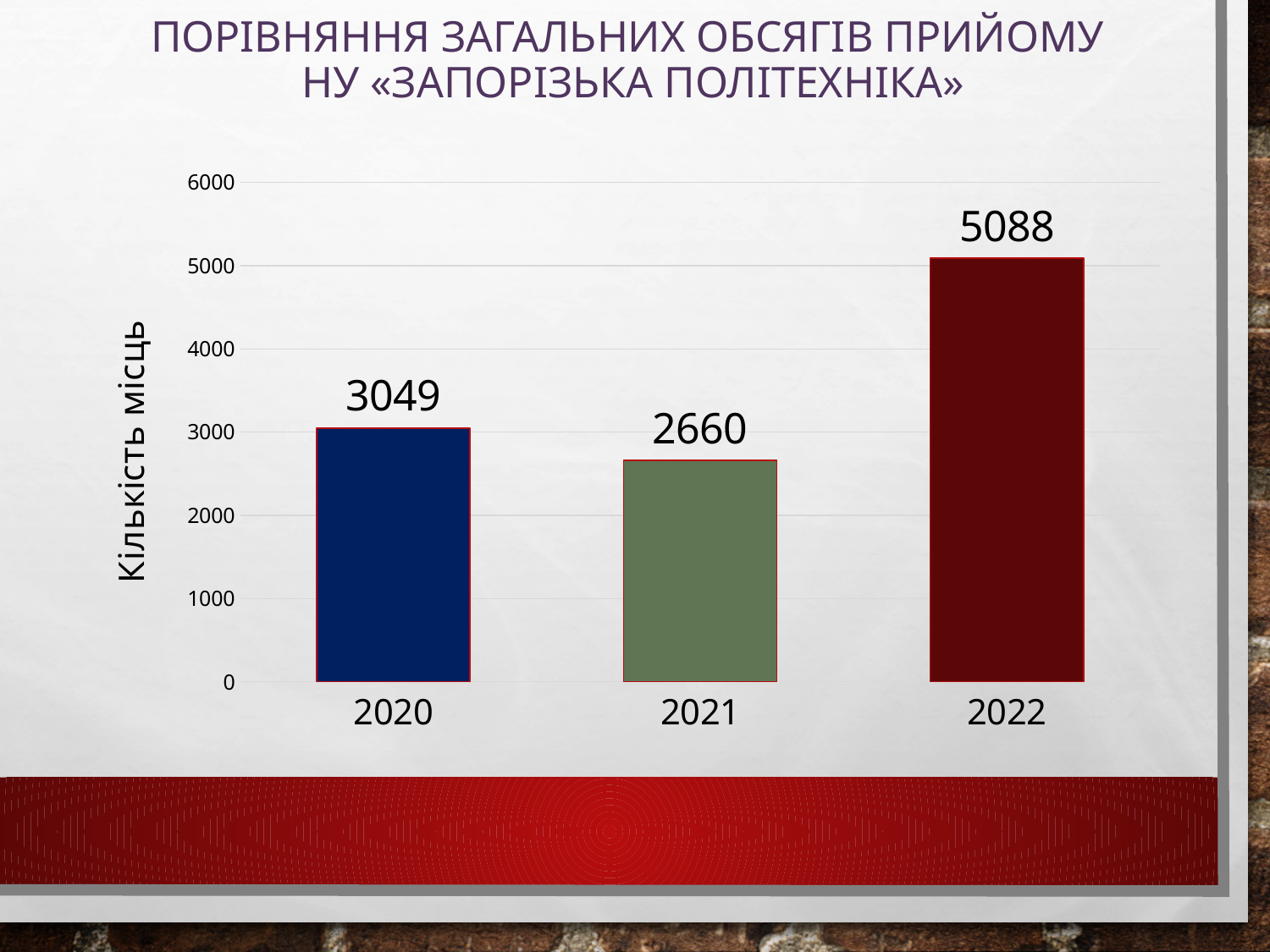
Which year has the highest value? 2022 What kind of chart is shown on the slide? bar chart How many years are shown on the x axis? 3 Which is larger, the value for 2020 or the value for 2021? 2020 What is the value for 2020? 3049 What is the difference between the values for 2020 and 2021? 389 What is the value for 2021? 2660 What is the label of the vertical axis? Кількість місць What is the difference between the values for 2022 and 2020? 2039 What is the value for 2022? 5088 Is the value for 2022 greater or less than 4000? greater Which year has the lowest value? 2021